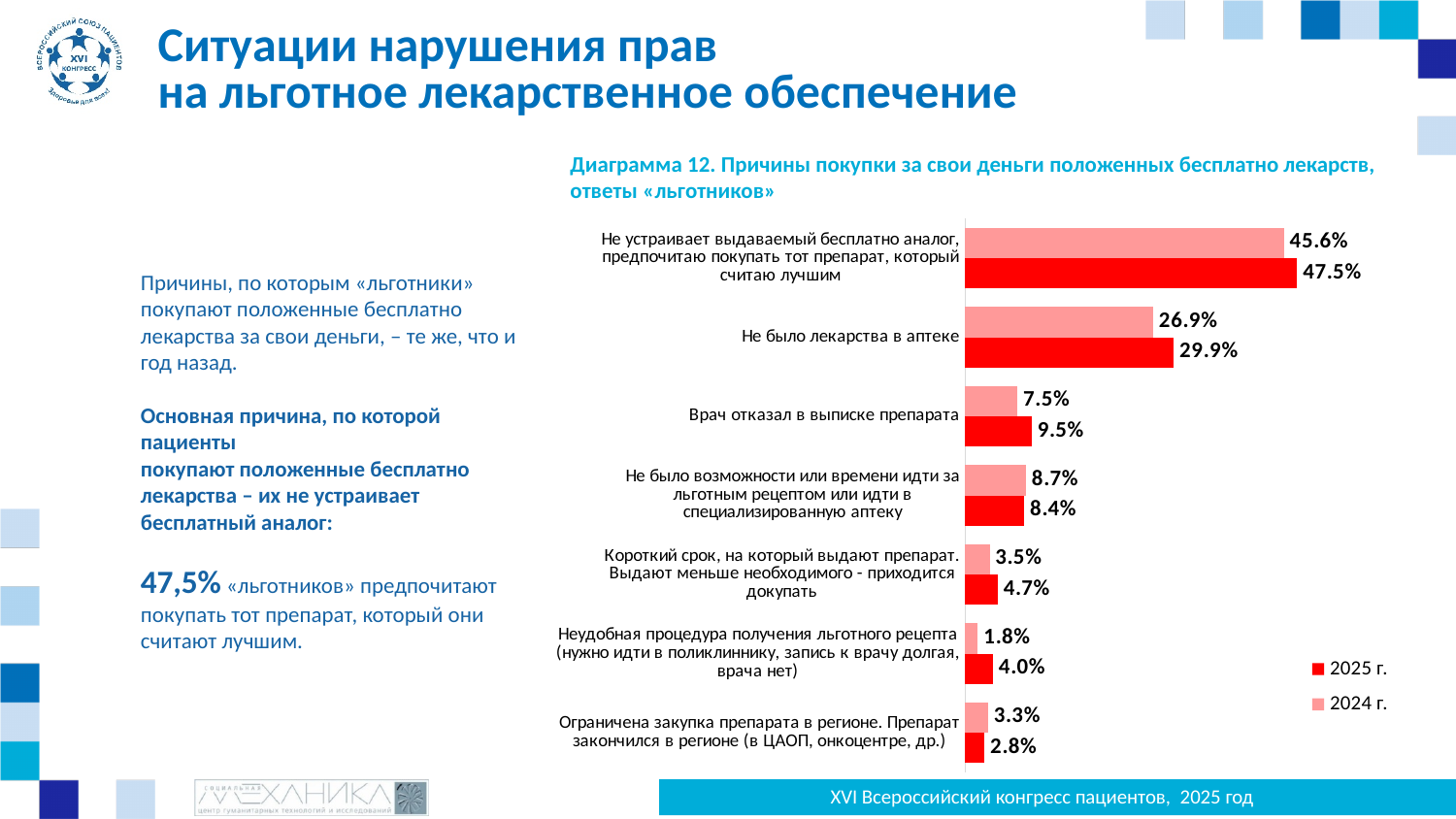
What is the 2025 г. value for «Не было лекарства в аптеке»? 29.9% For «Ограничена закупка препарата в регионе», which year has the larger value, 2024 г. or 2025 г.? 2024 г. For «Не было возможности или времени идти за льготным рецептом», which year has the larger value, 2024 г. or 2025 г.? 2024 г. Which category has the highest 2025 г. value? Не устраивает выдаваемый бесплатно аналог, предпочитаю покупать тот препарат, который считаю лучшим How many series does the chart legend list? 2 What is the 2024 г. value for «Врач отказал в выписке препарата»? 7.5% How many categories (reasons) are shown in the chart? 7 What is the 2025 г. value for «Неудобная процедура получения льготного рецепта»? 4.0% Which colour represents the 2024 г. series in the chart? light pink What type of chart is shown on the slide? bar chart Which category has the lowest 2024 г. value? Неудобная процедура получения льготного рецепта What is the difference between the 2025 г. and 2024 г. values for «Не устраивает выдаваемый бесплатно аналог»? 1.9%